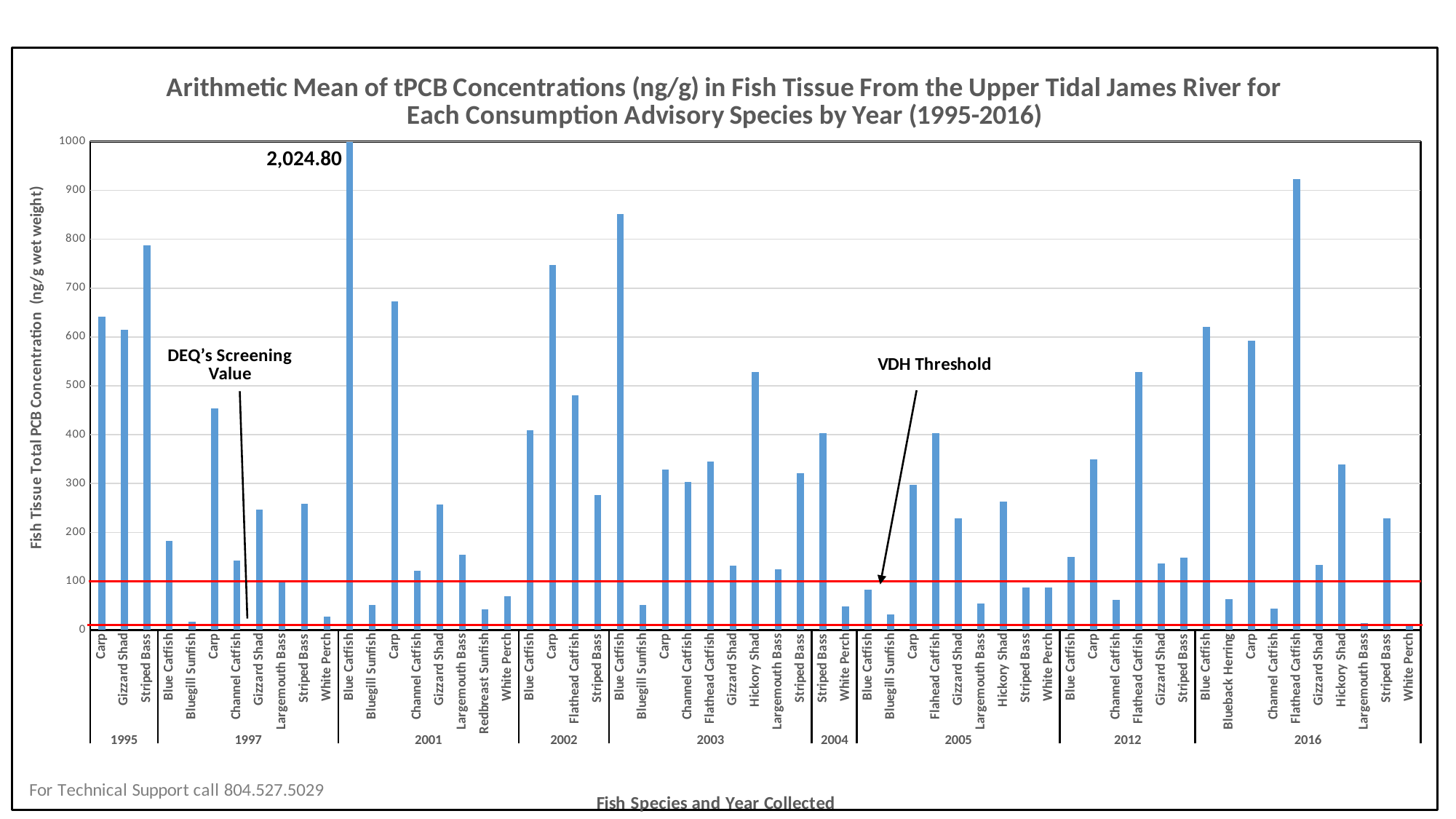
What kind of chart is shown on the slide? Bar chart Is the value for Blue Catfish in 2003 greater or less than 800? greater Which is larger, the value for Carp in 2002 or the value for Carp in 2016? Carp in 2002 Is the value for Carp in 1995 greater or less than 600? greater How many species are plotted for the year 2004? 2 Which species has the lowest tPCB concentration in the 1997 group? Bluegill Sunfish Which species and year has the highest tPCB concentration on the chart? Blue Catfish, 2001 Is the value for Hickory Shad in 2003 greater or less than 500? greater What are the two labelled horizontal red reference lines on the chart? DEQ's Screening Value and VDH Threshold What is the tPCB concentration value printed for Blue Catfish in 2001? 2,024.80 How many year groups are shown along the x axis? 9